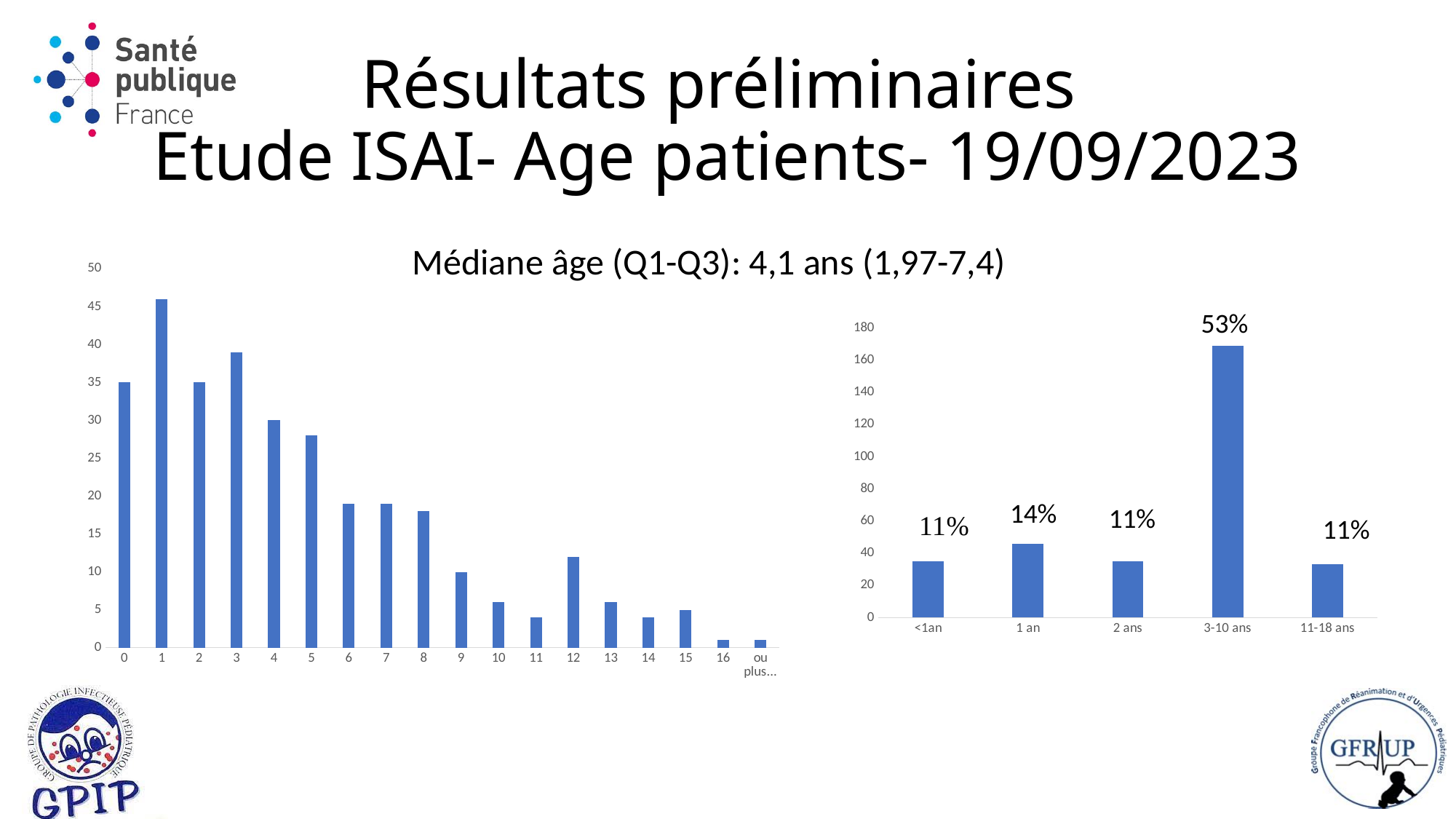
What kind of chart is the left chart? bar chart On the right chart, which age group has the highest value? 3-10 ans On the right chart, what is the percentage shown for the 3-10 ans age group? 53% On the right chart, what is the percentage shown for the 11-18 ans age group? 11% On the right chart, is the value for 3-10 ans greater or less than 160? greater On the right chart, is the value for 1 an greater or less than 40? greater On the left chart, is the value for age 3 greater or less than 35? greater On the right chart, what is the difference in percentage points between the 3-10 ans group and the 1 an group? 39% On the left chart, which age has the highest bar? 1 On the right chart, what is the percentage shown for the 1 an age group? 14% On the right chart, how many age groups are shown on the x axis? 5